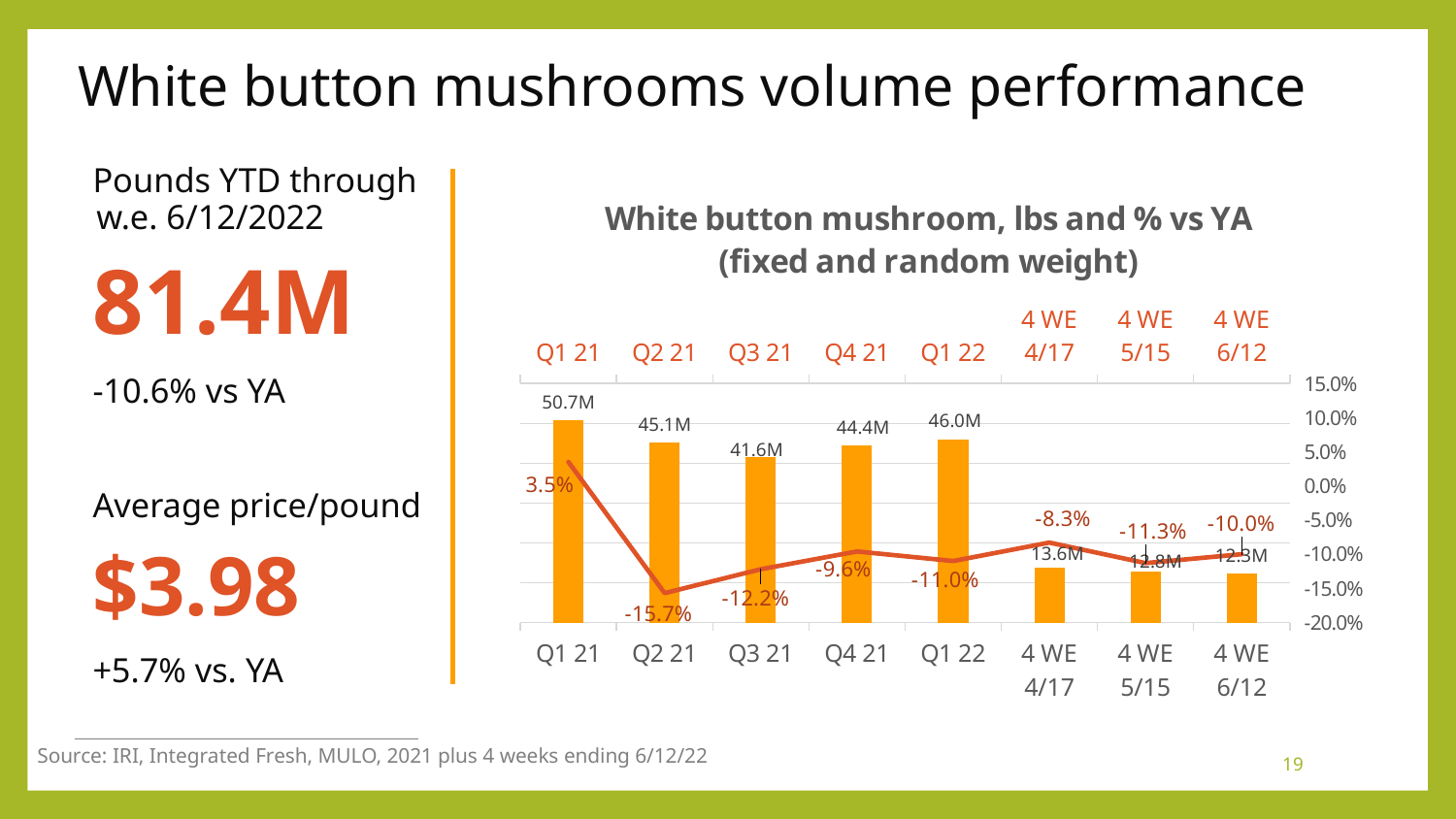
What is the % vs YA value for the 4 WE 4/17 period? -8.3% Do the volume bars rise or fall from Q1 21 to Q3 21? Fall What is the volume in pounds for Q1 21? 50.7M How many periods are shown on the x axis? 8 What is the % vs YA value for Q2 21? -15.7% Which period has the lowest % vs YA value? Q2 21 What is the title of the chart? White button mushroom, lbs and % vs YA (fixed and random weight) What is the volume in pounds for the 4 WE 6/12 period? 12.3M What kind of chart is this? Combined bar and line chart Which period has the highest volume in pounds? Q1 21 What is the difference in pounds between Q1 21 and Q2 21? 5.6M Which is larger, the volume for Q4 21 or Q1 22? Q1 22